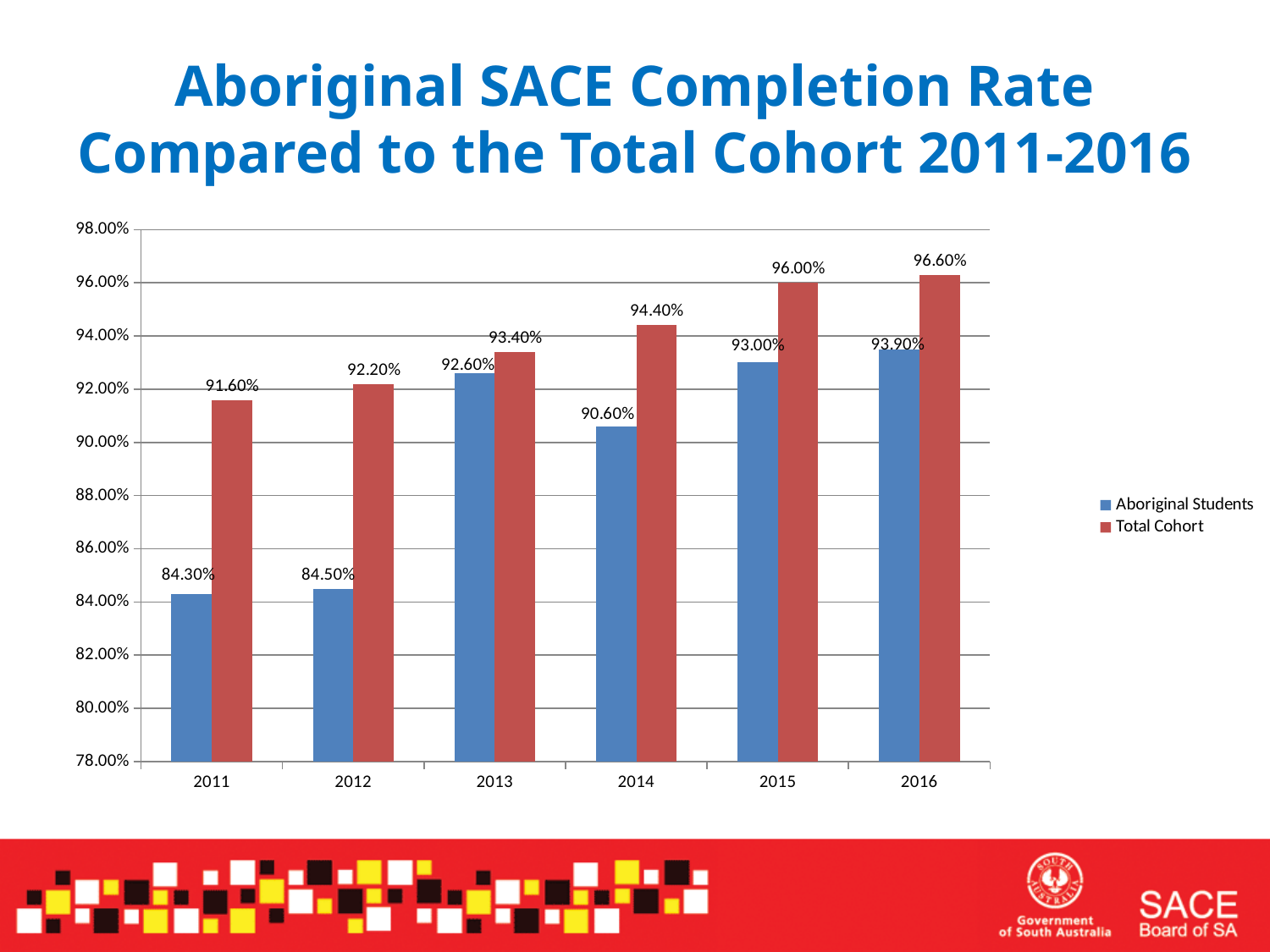
Is the value for Aboriginal Students in 2014 greater or less than 92.00%? less What is the value for Aboriginal Students in 2015? 93.00% What is the value for Total Cohort in 2014? 94.40% Does the Total Cohort value rise or fall from 2011 to 2016? rise What is the value for Aboriginal Students in 2011? 84.30% How many years are shown on the x axis? 6 What kind of chart is shown on the slide? bar chart How many series does the legend list? 2 In which year is the Aboriginal Students value lowest? 2011 In which year is the Total Cohort value highest? 2016 What is the difference between the Total Cohort and Aboriginal Students values in 2011? 7.30% Which is larger in 2013: the Aboriginal Students value or the Total Cohort value? Total Cohort